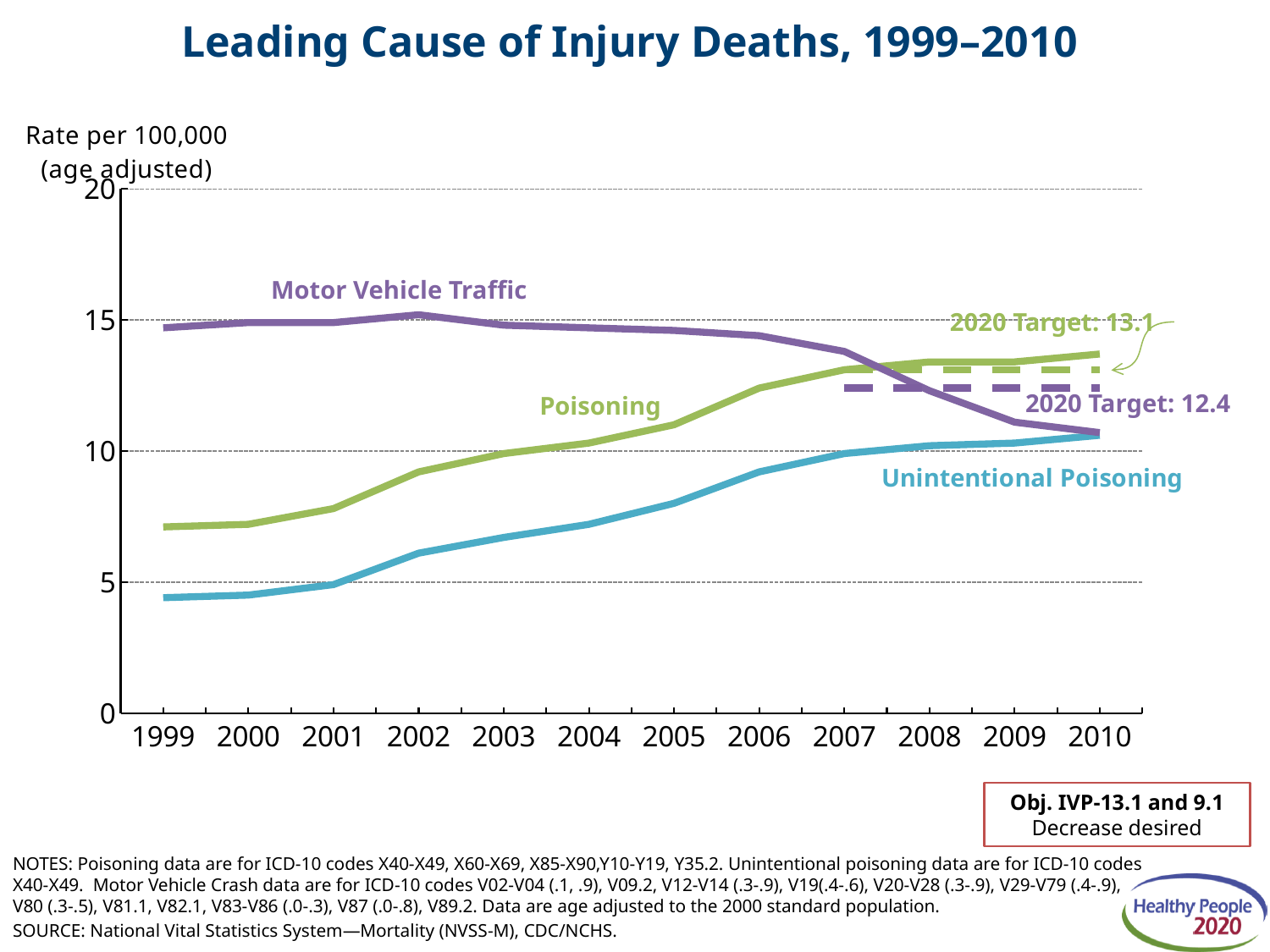
Is the Unintentional Poisoning rate in 1999 greater or less than 5? less What kind of chart is shown on the slide? line chart Which series has the lowest rate in 1999? Unintentional Poisoning What is the 2020 target for Motor Vehicle Traffic shown on the chart? 12.4 What is the 2020 target for Poisoning shown on the chart? 13.1 How many data series (lines) are plotted on the chart? 5 Is the Poisoning rate in 2010 greater or less than 10? greater Does the Motor Vehicle Traffic rate rise or fall from 1999 to 2010? fall How many years are shown along the x axis? 12 Which series has the highest rate in 1999? Motor Vehicle Traffic In 2002, which is larger: the Motor Vehicle Traffic rate or the Poisoning rate? Motor Vehicle Traffic Does the Poisoning rate rise or fall from 1999 to 2010? rise